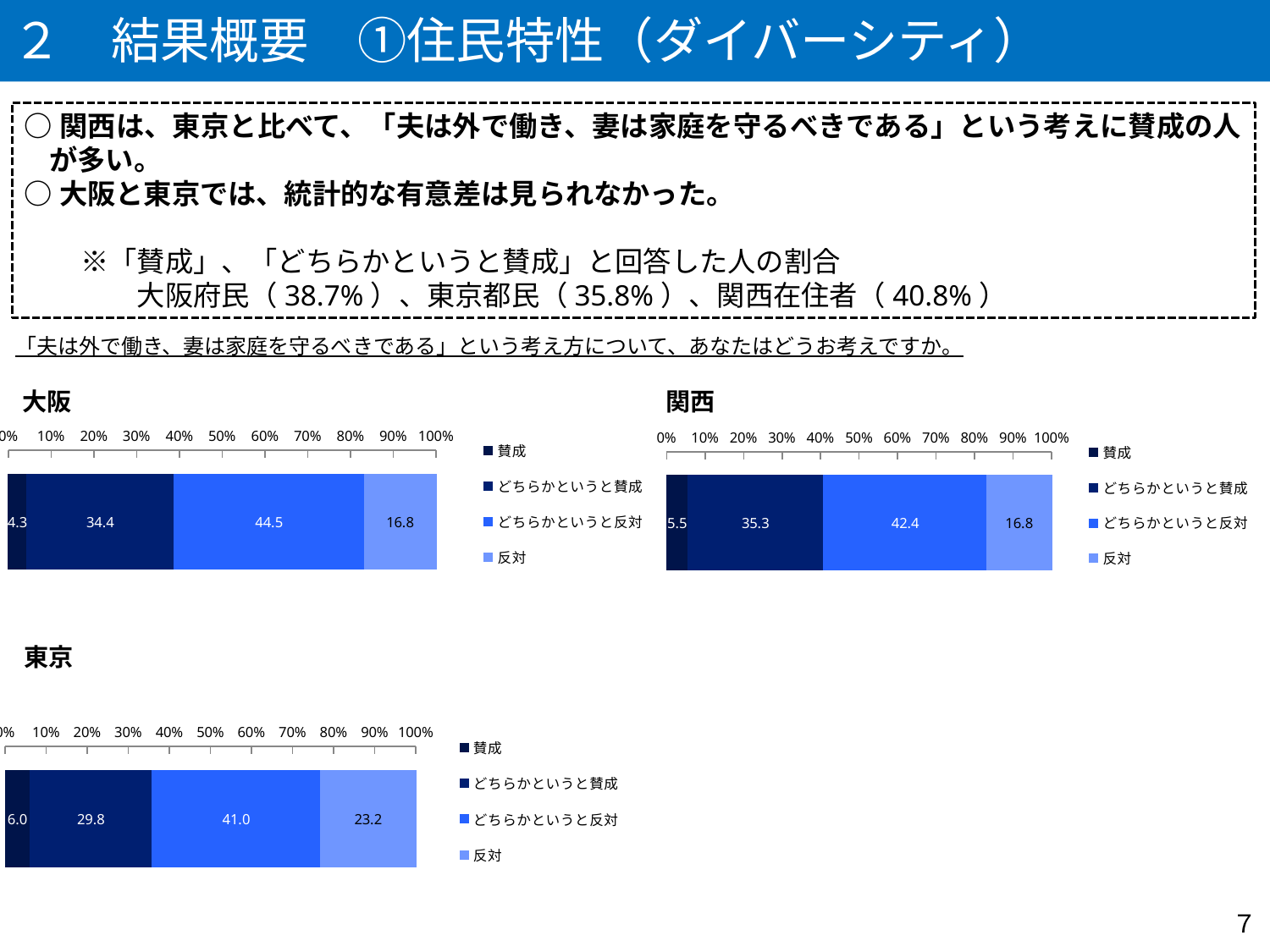
In the 関西 chart, what is the value for どちらかというと賛成? 35.3 In the 東京 chart, what is the value for 反対? 23.2 In the 大阪 chart, which response category has the largest share? どちらかというと反対 How many series does the legend of the 大阪 chart list? 4 In the 関西 chart, what is the value for 反対? 16.8 What kind of chart is the 東京 chart? Stacked bar chart In the 大阪 chart, what is the value for どちらかというと反対? 44.5 Which chart has the larger value for どちらかというと反対, 大阪 or 関西? 大阪 What is the difference between the どちらかというと賛成 value in the 関西 chart and the どちらかというと賛成 value in the 東京 chart? 5.5 In the 東京 chart, which response category has the smallest share? 賛成 How many charts are shown on the slide? 3 What is the difference between the 反対 value in the 東京 chart and the 反対 value in the 大阪 chart? 6.4